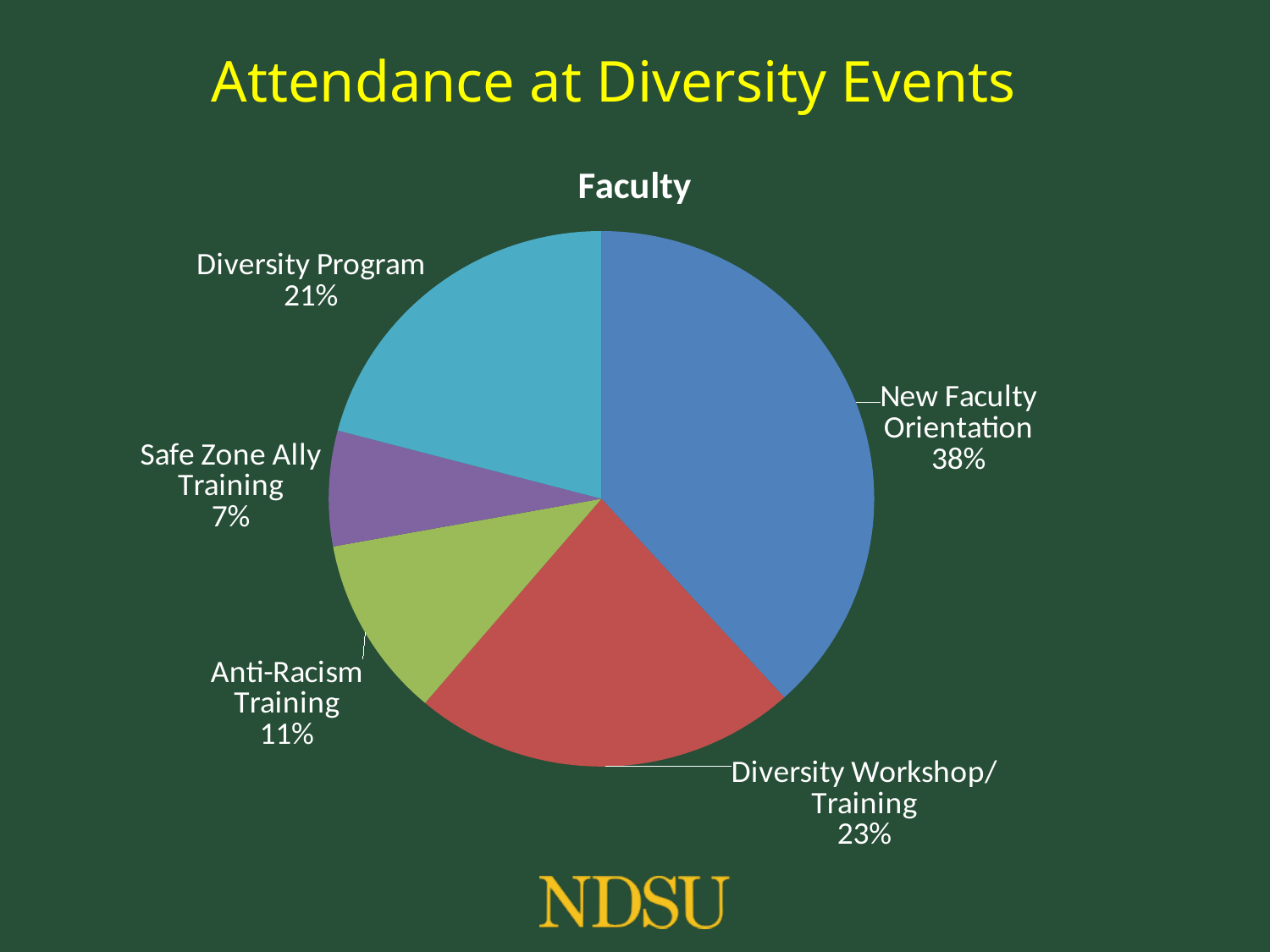
What percentage of faculty attendance is for New Faculty Orientation? 38% What percentage of faculty attendance is for Diversity Workshop/Training? 23% Which has a larger share, Anti-Racism Training or Safe Zone Ally Training? Anti-Racism Training Which event has the largest share of faculty attendance? New Faculty Orientation What kind of chart is shown on the slide? pie chart What is the chart's title? Faculty How many event categories are shown in the pie chart? 5 What percentage of faculty attendance is for Anti-Racism Training? 11% What percentage of faculty attendance is for Safe Zone Ally Training? 7% What percentage of faculty attendance is for Diversity Program? 21% What is the difference in percentage points between New Faculty Orientation and Diversity Workshop/Training? 15 Which event has the smallest share of faculty attendance? Safe Zone Ally Training